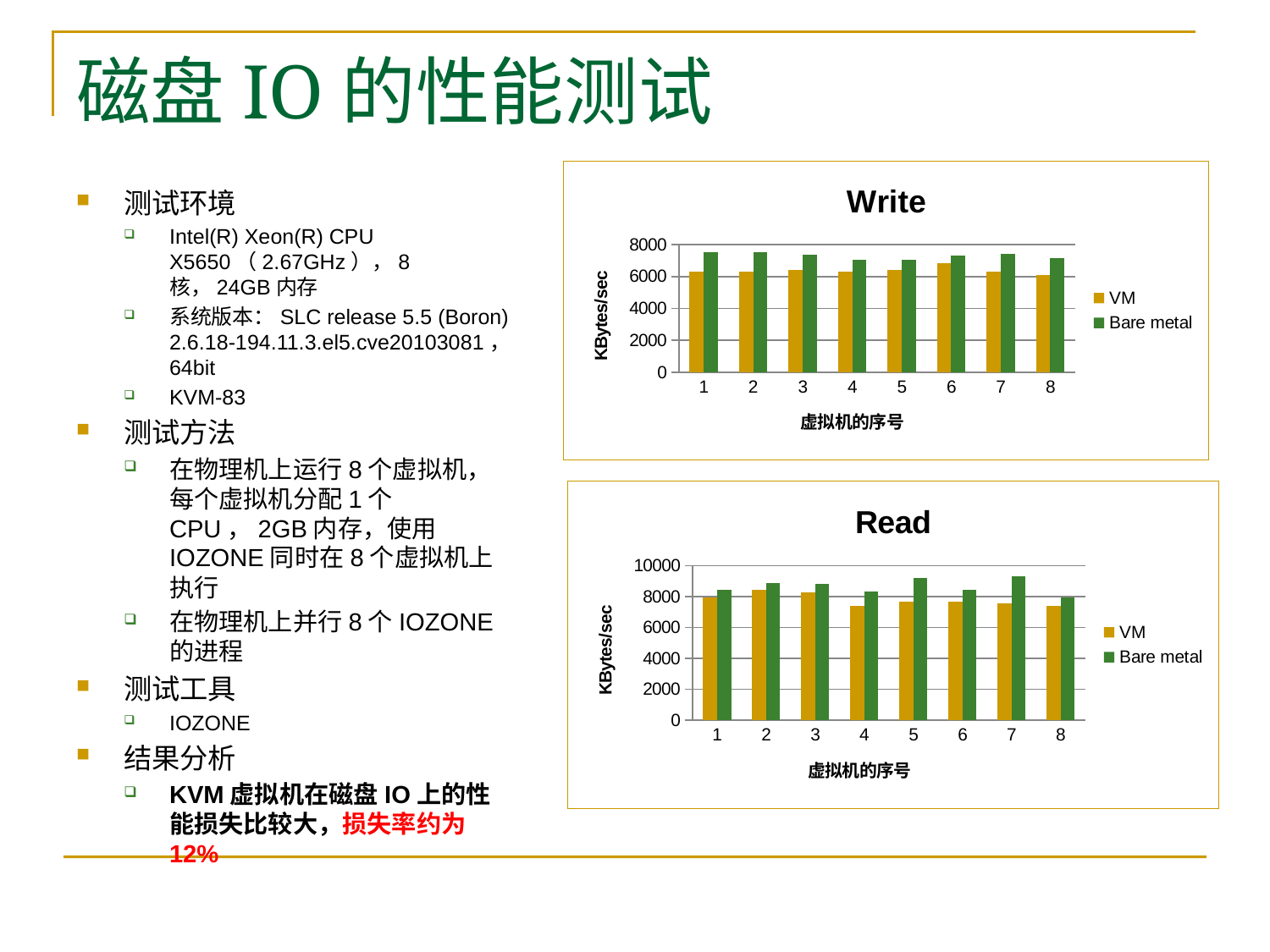
In the Write chart, which series is larger for virtual machine 3, VM or Bare metal? Bare metal What kind of chart is the Write chart? bar chart In the Write chart, is the Bare metal value for virtual machine 1 greater or less than 6000? greater How many series does the legend of the Read chart list? 2 What is the y-axis label of the Read chart? KBytes/sec What are the two legend entries in the Write chart? VM and Bare metal In the Read chart, is the Bare metal value for virtual machine 7 greater or less than 8000? greater In the Read chart, is the VM value for virtual machine 4 greater or less than 8000? less In the Read chart, which is larger, the VM value for virtual machine 2 or the VM value for virtual machine 4? virtual machine 2 In the Read chart, which series is larger for virtual machine 5, VM or Bare metal? Bare metal How many virtual machine numbers are shown on the x axis of the Write chart? 8